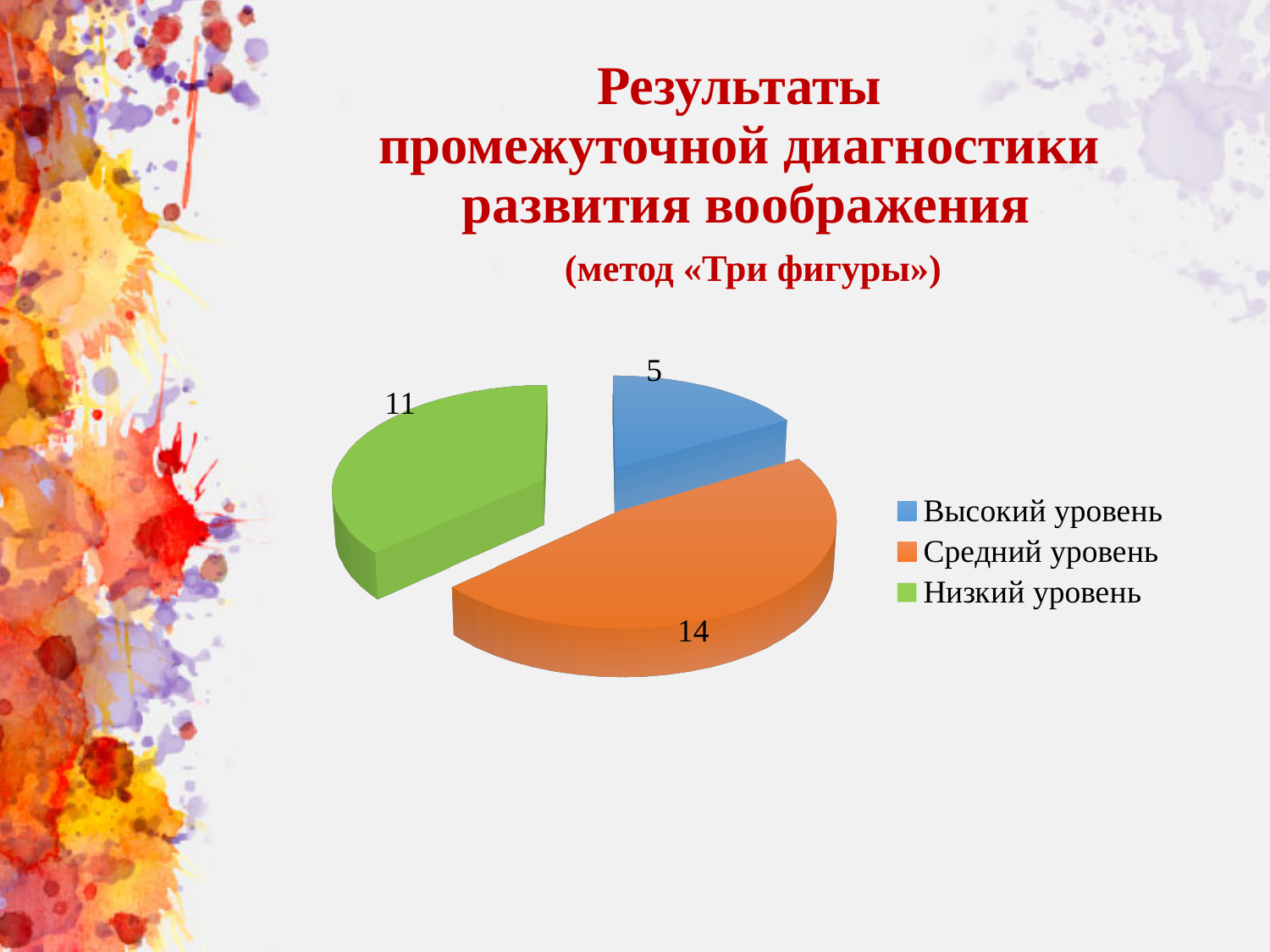
What is the value for Низкий уровень? 11 What is the difference between the values for Низкий уровень and Высокий уровень? 6 What is the value for Средний уровень? 14 Which is larger, the value for Низкий уровень or the value for Высокий уровень? Низкий уровень How many slices does the pie chart have? 3 What is the total of all the values shown in the pie chart? 30 Which level has the largest slice of the pie? Средний уровень What is the difference between the values for Средний уровень and Низкий уровень? 3 What kind of chart is shown on the slide? Pie chart What is the value for Высокий уровень? 5 Which level has the smallest slice of the pie? Высокий уровень Which colour represents Низкий уровень in the legend? Green